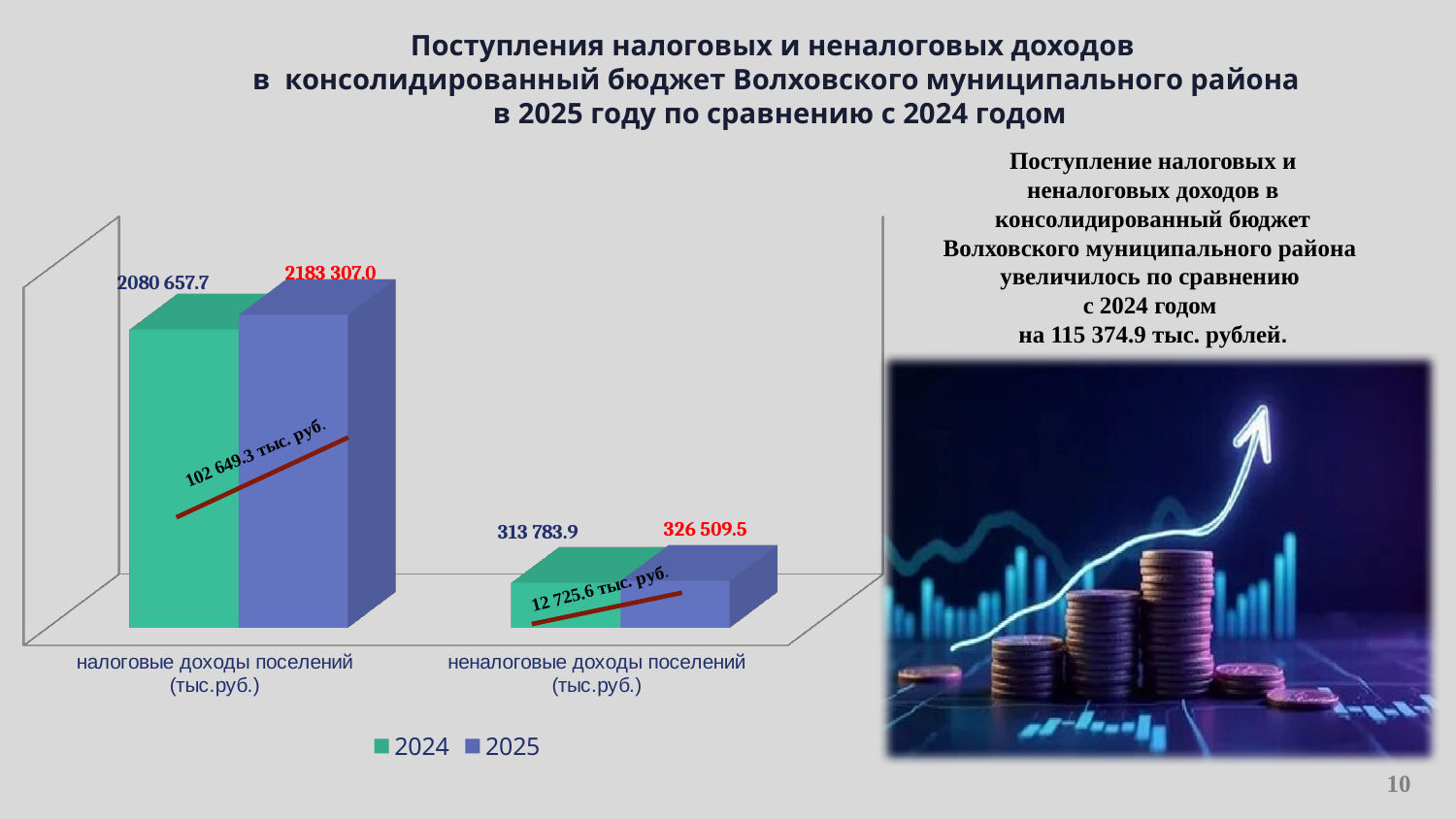
What is the value for неналоговые доходы поселений in 2024? 313 783.9 Which is larger for налоговые доходы поселений: the 2024 value or the 2025 value? 2025 Which category has the highest value in 2025? налоговые доходы поселений How many categories are shown on the x axis? 2 What is the value for налоговые доходы поселений in 2025? 2183 307.0 What type of chart is shown on the slide? Bar chart By how much did неналоговые доходы поселений increase from 2024 to 2025? 12 725.6 тыс. руб. By how much did налоговые доходы поселений increase from 2024 to 2025? 102 649.3 тыс. руб. What is the value for налоговые доходы поселений in 2024? 2080 657.7 What is the value for неналоговые доходы поселений in 2025? 326 509.5 Which category has the lowest value in 2024? неналоговые доходы поселений How many series does the legend list? 2